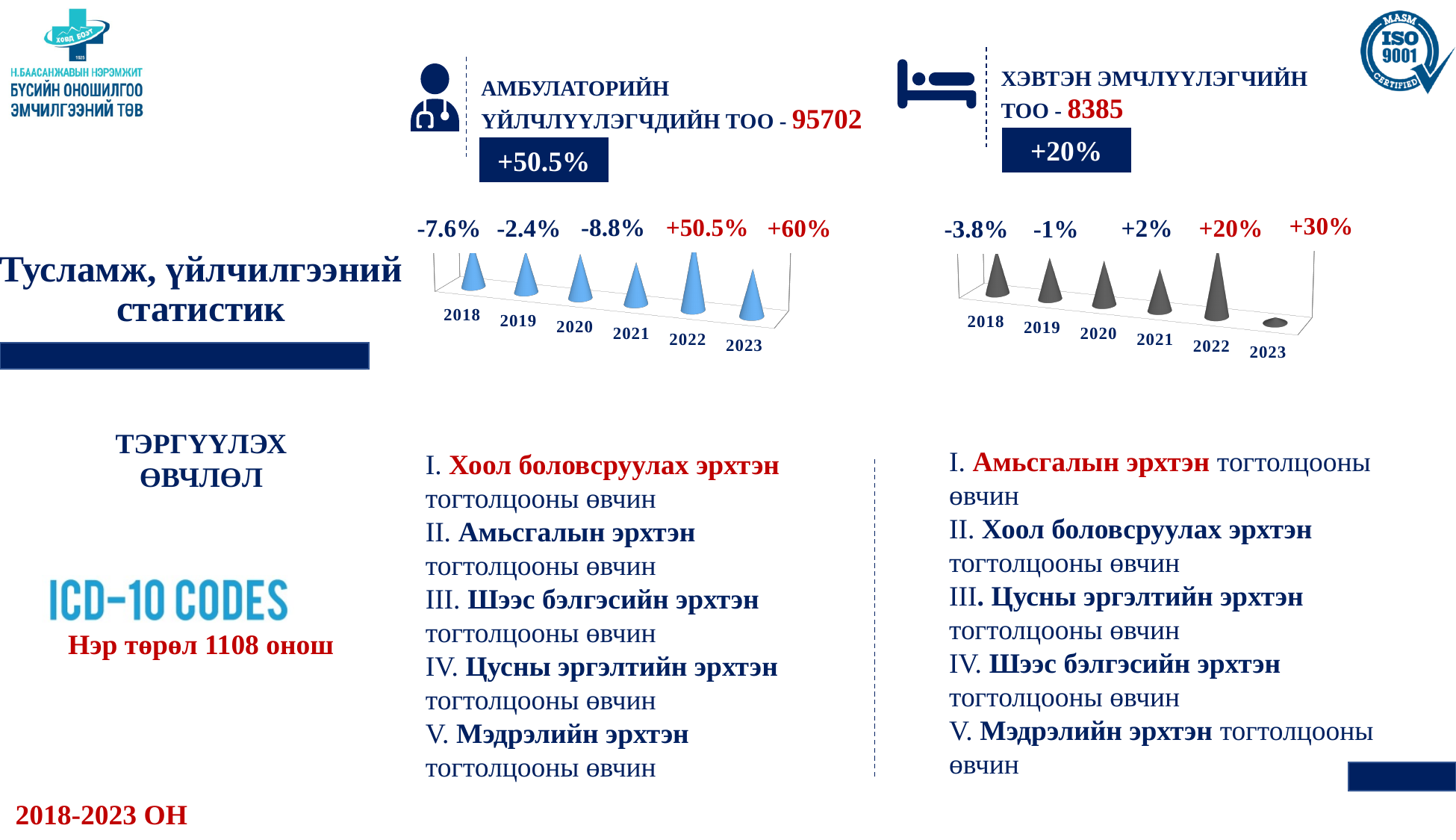
In the right (gray) chart, which is larger, the value for 2022 or the value for 2023? 2022 In the right (gray) chart, which year has the tallest cone? 2022 What kind of chart is the left chart (blue cones) showing ambulatory service users by year? bar chart How many years are shown on the x axis of the right (gray) chart? 6 How many years are shown on the x axis of the left (blue) chart? 6 What colour are the cones in the right chart for inpatient (ХЭВТЭН ЭМЧЛҮҮЛЭГЧИЙН) data? gray In the left (blue) chart, which is larger, the value for 2022 or the value for 2021? 2022 In the right (gray) chart, which year has the smallest value? 2023 What is the first year shown on the x axis of both charts? 2018 In the left (blue) chart, which year has the tallest cone? 2022